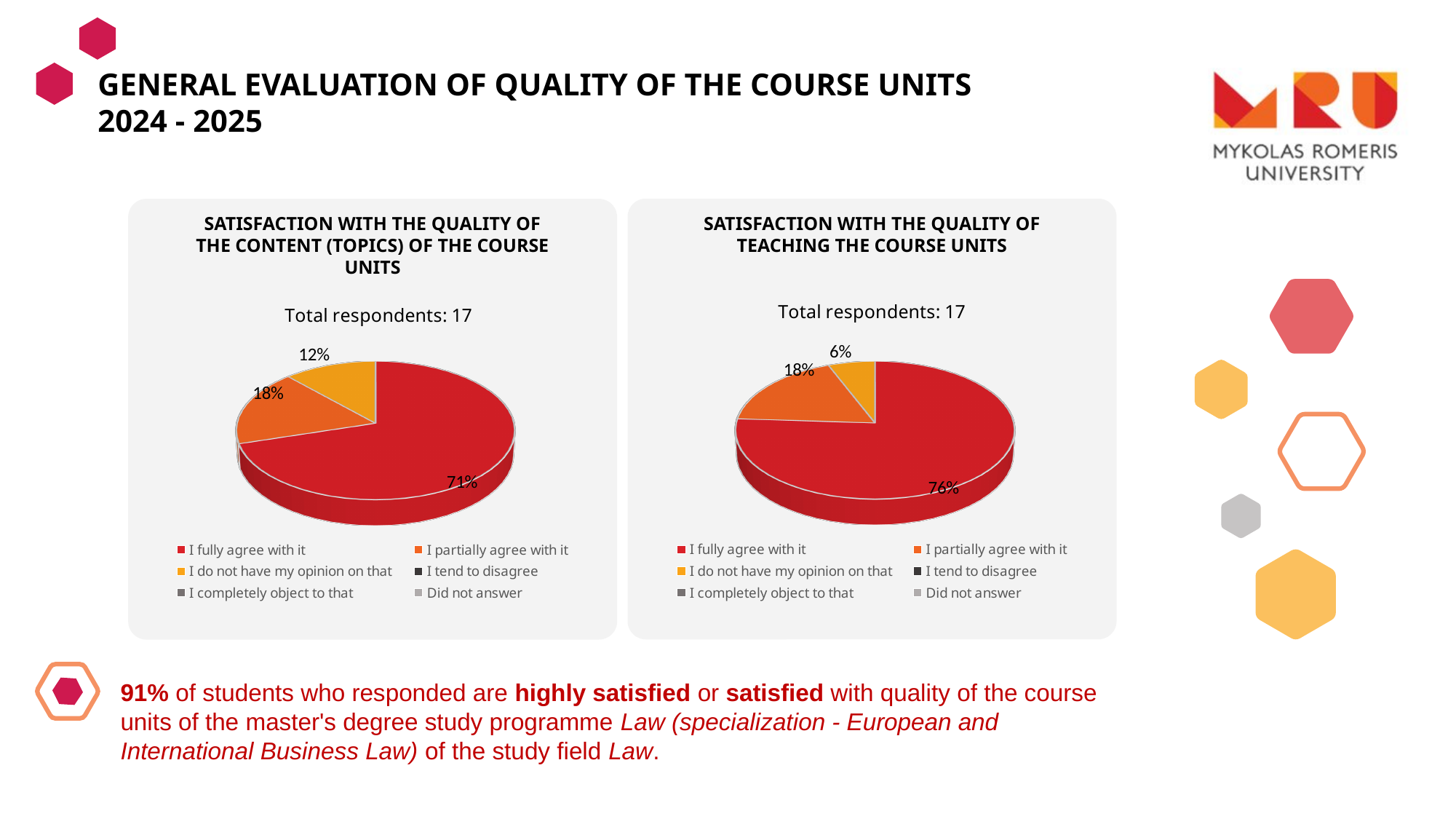
How many entries does the legend of the left chart list? 6 What type of chart is used on this slide? Pie chart In the left chart (content of the course units), what percentage is shown for 'I do not have my opinion on that'? 12% In the chart titled 'Satisfaction with the quality of teaching the course units', what share of respondents chose 'I fully agree with it'? 76% In the right chart (teaching the course units), what percentage is shown for 'I partially agree with it'? 18% In the left chart (content of the course units), which response has the largest slice? I fully agree with it In the chart titled 'Satisfaction with the quality of the content (topics) of the course units', what share of respondents chose 'I fully agree with it'? 71% Which chart has a larger 'I fully agree with it' share: the content chart or the teaching chart? The teaching chart How many total respondents are reported for the chart on teaching the course units? 17 In the right chart (teaching the course units), what percentage is shown for 'I do not have my opinion on that'? 6% What is the difference between the 'I fully agree with it' share in the teaching chart and the 'I fully agree with it' share in the content chart? 5 percentage points In the right chart (teaching the course units), which labelled response has the smallest slice? I do not have my opinion on that